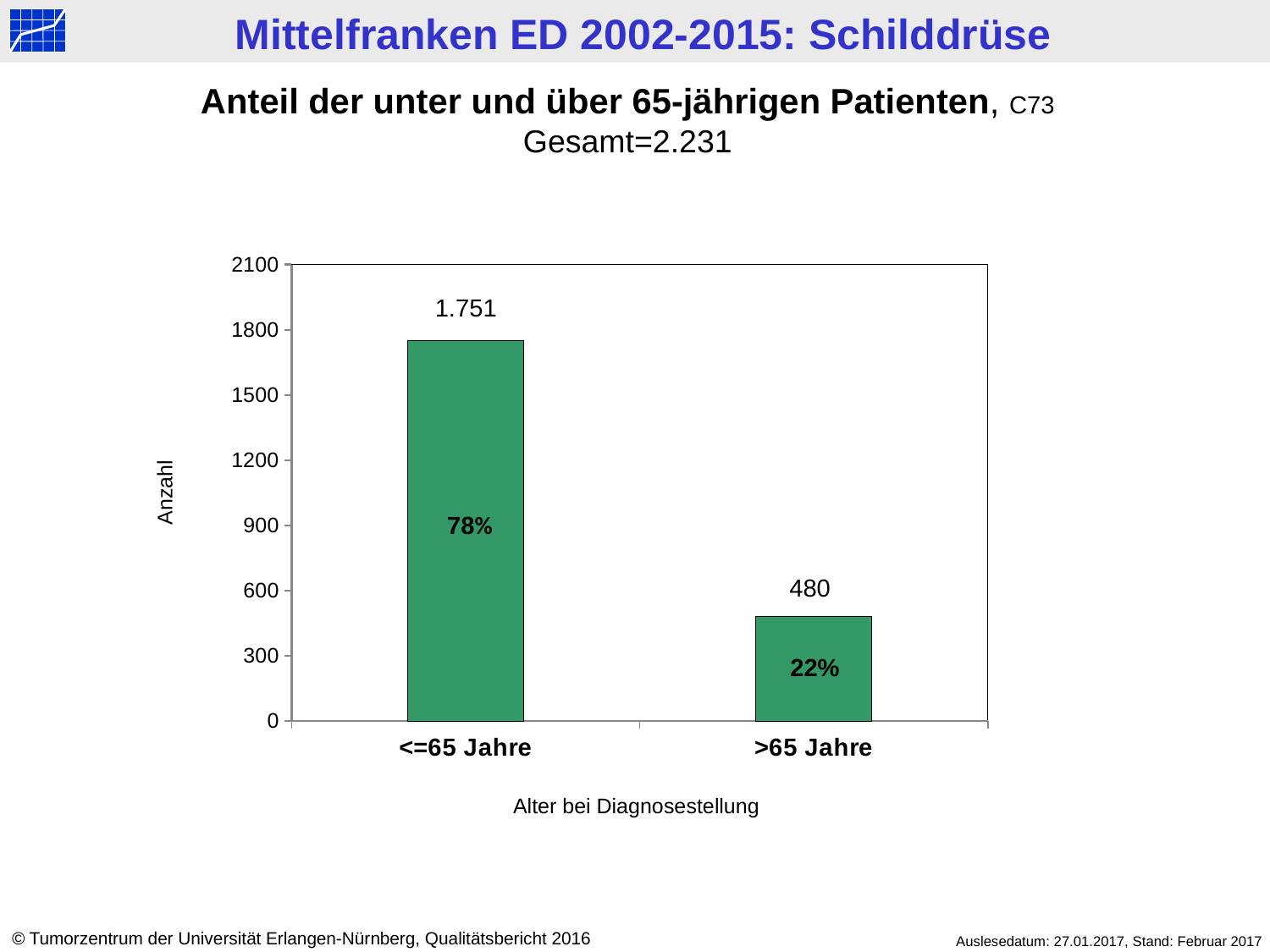
Which category has the highest value? <=65 Jahre What is the value for the >65 Jahre category? 480 What percentage is shown on the bar for >65 Jahre? 22% Is the value for >65 Jahre greater or less than 600? less Which category has the lowest value? >65 Jahre What is the difference between the values for <=65 Jahre and >65 Jahre? 1.271 What percentage is shown on the bar for <=65 Jahre? 78% What kind of chart is shown on the slide? bar chart What is the value for the <=65 Jahre category? 1.751 How many categories are shown on the x axis? 2 Which is larger, the value for <=65 Jahre or for >65 Jahre? <=65 Jahre What is the label of the x axis? Alter bei Diagnosestellung